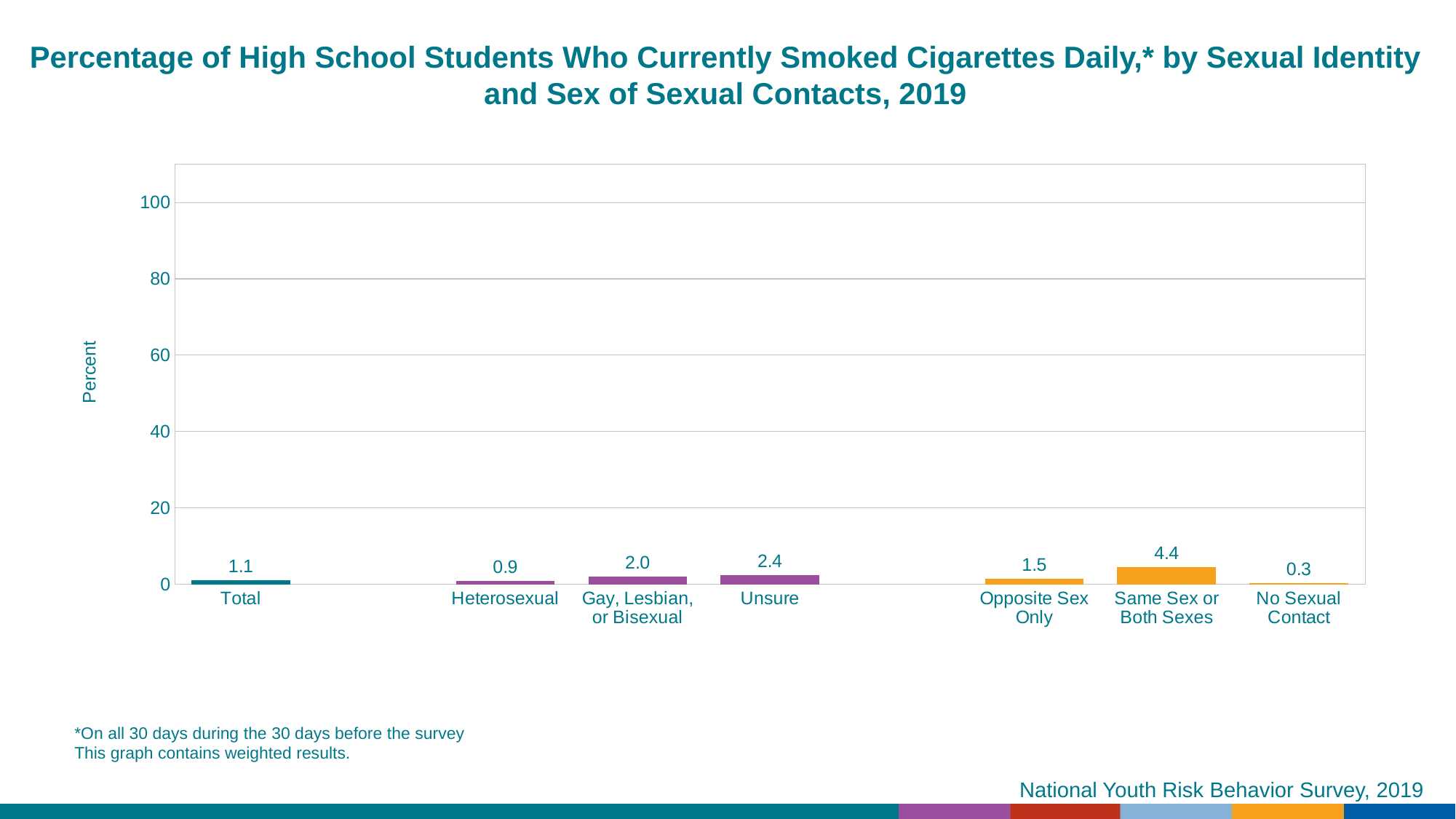
Which category has the lowest value on the chart? No Sexual Contact What is the difference between the values for Unsure and Heterosexual students? 1.5 What kind of chart is shown on the slide? bar chart What is the value shown for Heterosexual students? 0.9 What percentage of students in the Total category currently smoked cigarettes daily? 1.1 Which is larger, the value for Unsure or the value for Opposite Sex Only? Unsure Is the value for Same Sex or Both Sexes greater or less than 20? less What is the value shown for students with Same Sex or Both Sexes sexual contacts? 4.4 What is the value shown for Gay, Lesbian, or Bisexual students? 2.0 What is the difference between the values for Same Sex or Both Sexes and Opposite Sex Only? 2.9 How many categories are shown on the x axis? 7 Which category has the highest value on the chart? Same Sex or Both Sexes